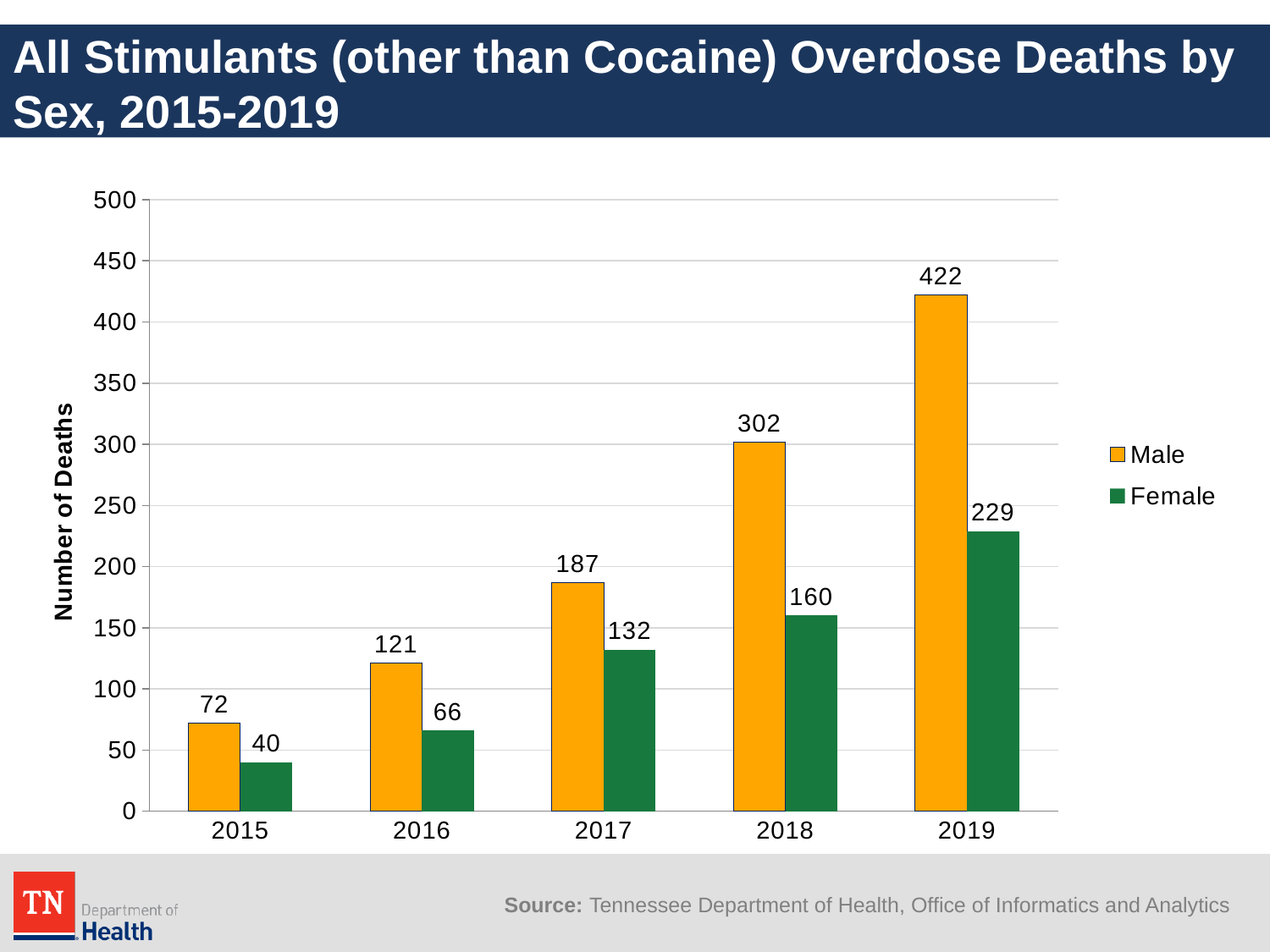
How many series does the legend list? 2 What is the value for Female in 2019? 229 Which is larger: Female deaths in 2017 or Male deaths in 2016? Female deaths in 2017 What kind of chart is shown on the slide? Bar chart Do Male deaths rise or fall from 2015 to 2019? Rise What is the difference between Male deaths in 2019 and Male deaths in 2018? 120 Which year has the lowest number of Female deaths? 2015 What is the difference between Male and Female deaths in 2018? 142 How many years are shown on the x axis? 5 How many Male overdose deaths were there in 2017? 187 What is the value for Female in 2015? 40 Which year has the highest number of Male deaths? 2019